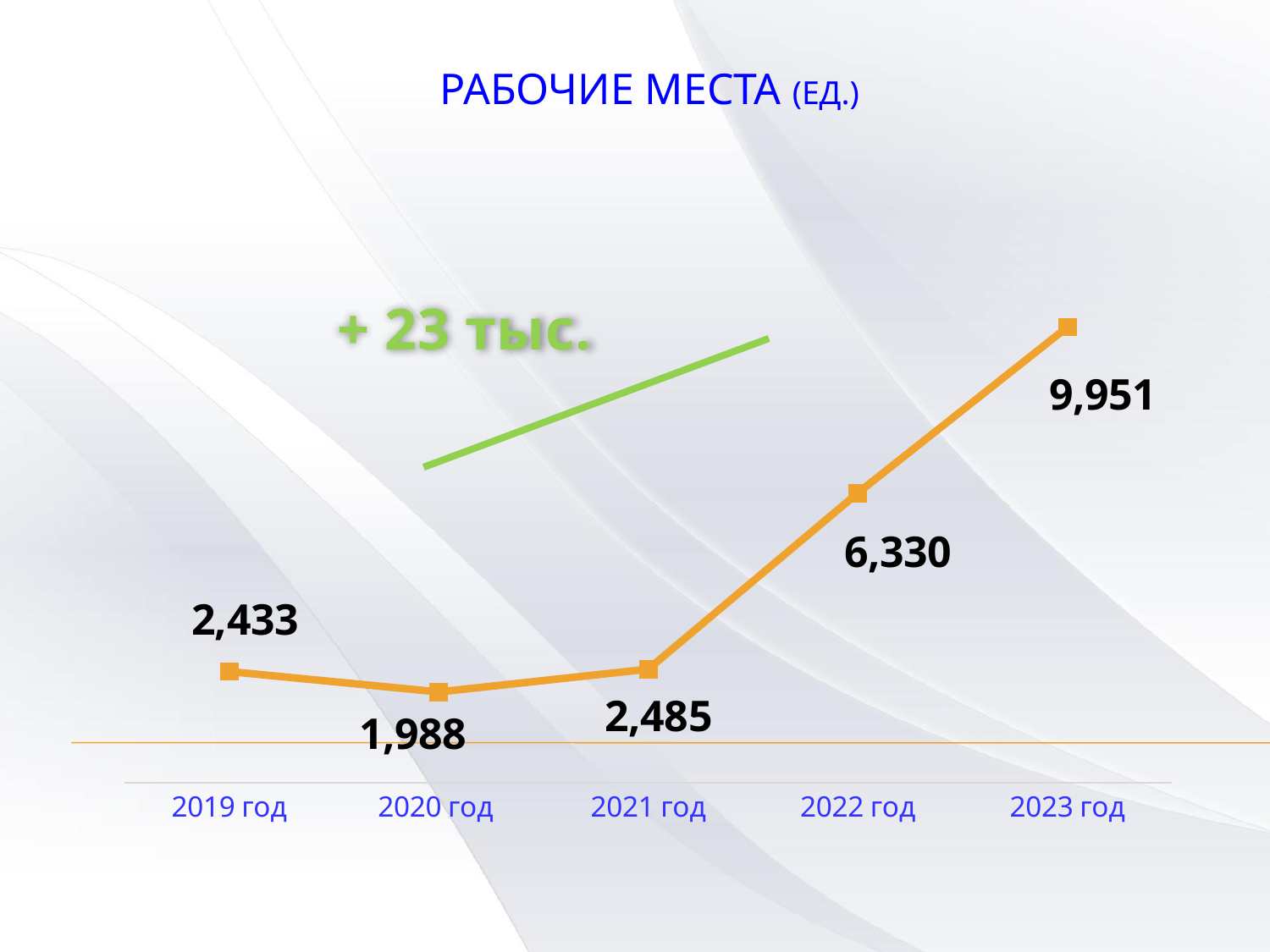
Which year has the highest value? 2023 год What is the value for 2022 год? 6,330 What is the difference between the values for 2021 год and 2020 год? 497 What is the difference between the values for 2023 год and 2022 год? 3,621 Which is larger, the value for 2019 год or the value for 2021 год? 2021 год How many years are plotted on the chart? 5 What is the value for 2019 год? 2,433 Which year has the lowest value? 2020 год What kind of chart is shown on the slide? Line chart What is the title of the chart? РАБОЧИЕ МЕСТА (ЕД.) What is the value for 2023 год? 9,951 What is the value for 2020 год? 1,988